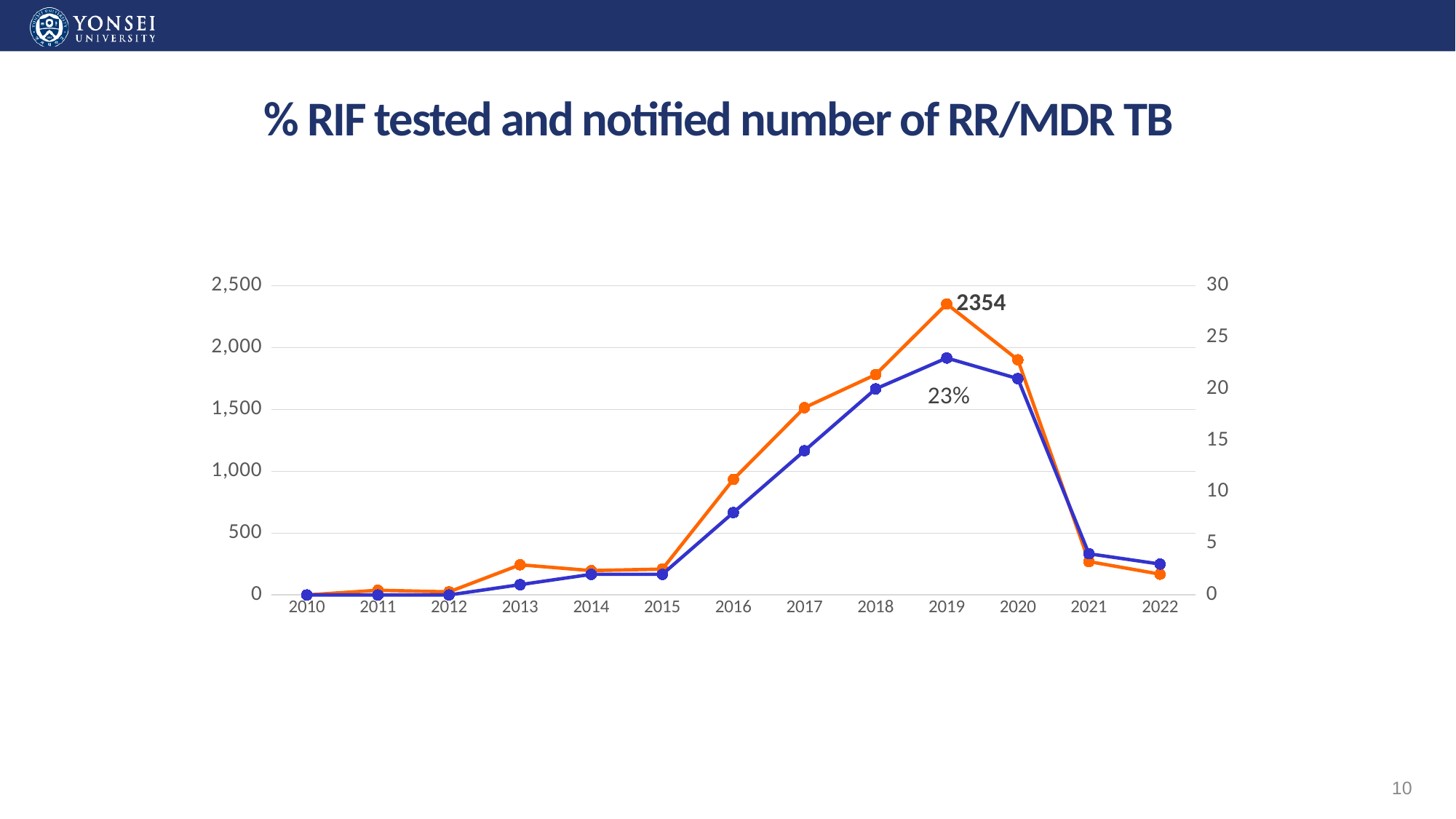
In which year does the orange line reach its highest value? 2019 Which year has the larger value on the orange line, 2019 or 2020? 2019 What is the labelled value of the orange line in 2019? 2354 What is the labelled value of the blue line in 2019? 23% Does the orange line rise or fall from 2015 to 2019? rise How many lines are plotted on the chart? 2 What kind of chart is shown on the slide? line chart What is the title of the slide's chart? % RIF tested and notified number of RR/MDR TB Is the value of the orange line in 2021 greater or less than 500 on the left axis? less How many years are shown on the x axis of the chart? 13 Is the value of the orange line in 2016 greater or less than 500 on the left axis? greater In which year does the blue line reach its highest value? 2019